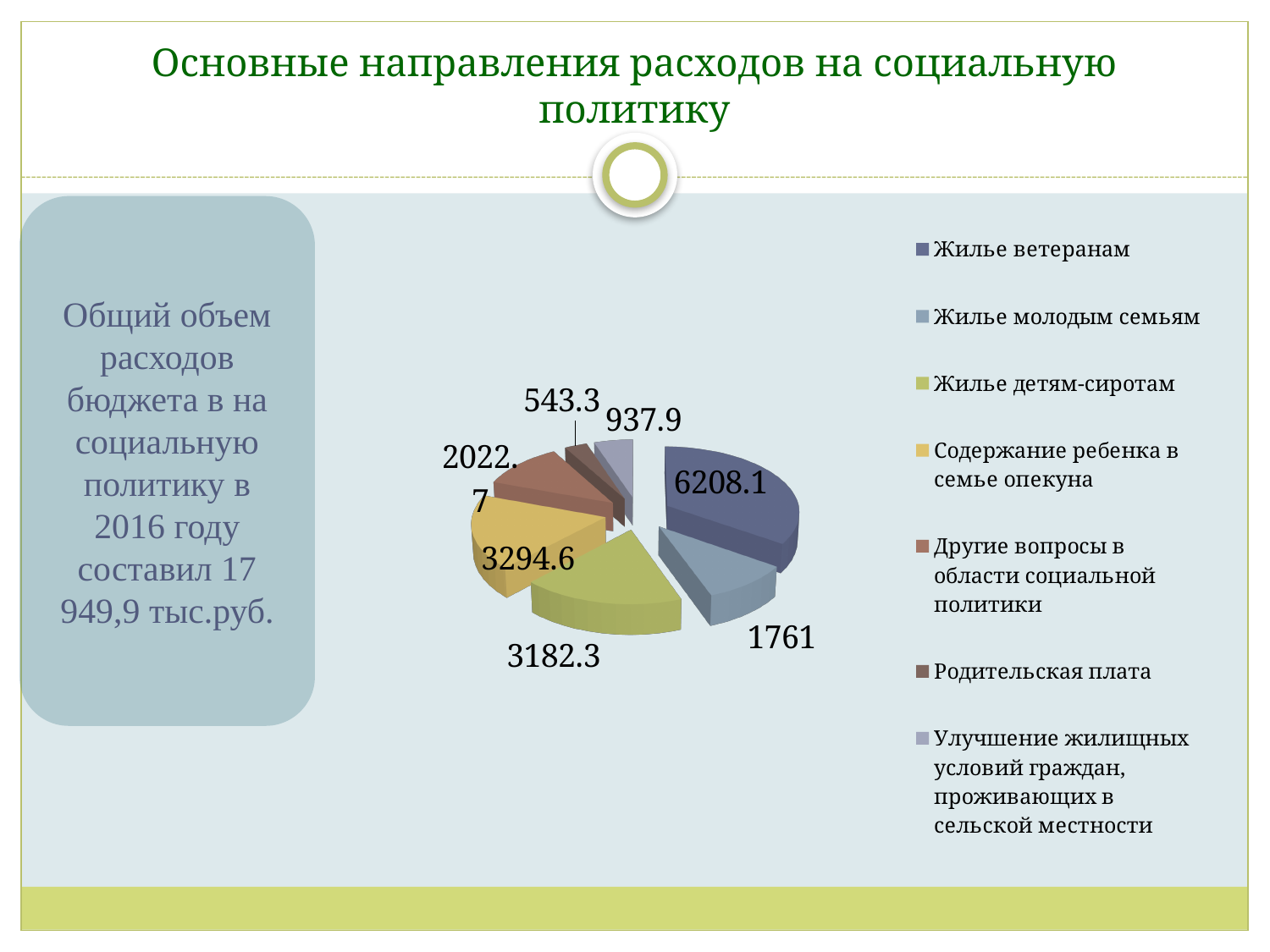
Which category has the largest slice of the pie? Жилье ветеранам What is the value for Жилье детям-сиротам? 3182.3 What is the difference between the values for Жилье ветеранам and Жилье молодым семьям? 4447.1 Which category has the smallest slice of the pie? Родительская плата What is the difference between the values for Другие вопросы в области социальной политики and Родительская плата? 1479.4 What kind of chart is shown on the slide? Pie chart Which is larger: the value for Содержание ребенка в семье опекуна or the value for Жилье детям-сиротам? Содержание ребенка в семье опекуна What is the value for Жилье ветеранам? 6208.1 What is the value for Жилье молодым семьям? 1761 How many slices does the pie chart have? 7 What is the value for Родительская плата? 543.3 What is the value for Содержание ребенка в семье опекуна? 3294.6